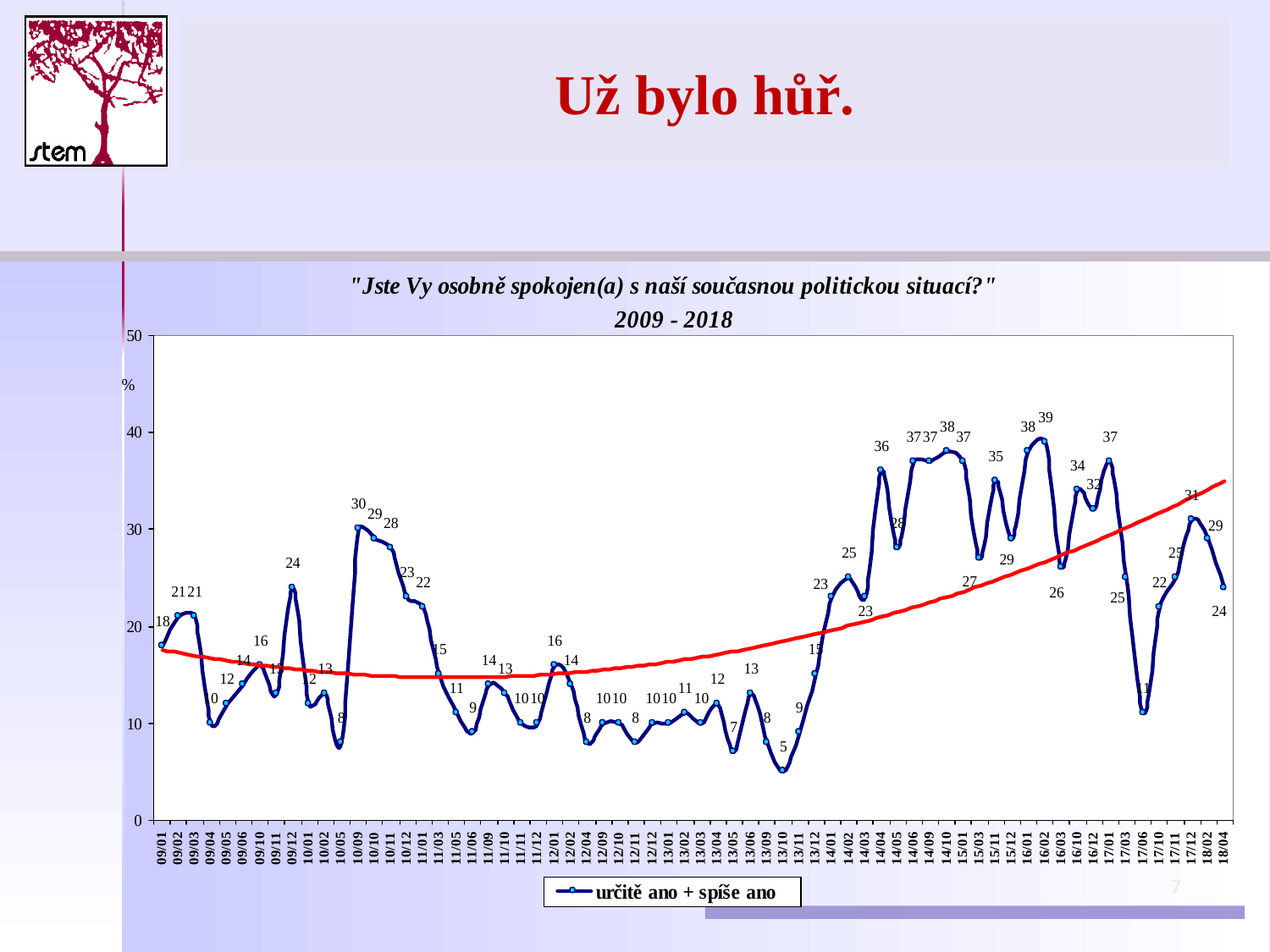
What is the value for 13/10? 5 Which is larger, the value for 09/12 or the value for 10/09? 10/09 How many series does the legend list? 1 Do the values rise or fall between 13/10 and 14/04? rise What is the legend entry for the plotted series? určitě ano + spíše ano Which point has the lowest value? 13/10 What kind of chart is shown on the slide? line chart What is the difference between the highest value (16/02) and the lowest value (13/10)? 34 What is the value for 14/04? 36 What is the value for 18/04? 24 Which point has the highest value? 16/02 What is the difference between the value for 18/04 and the value for 09/01? 6